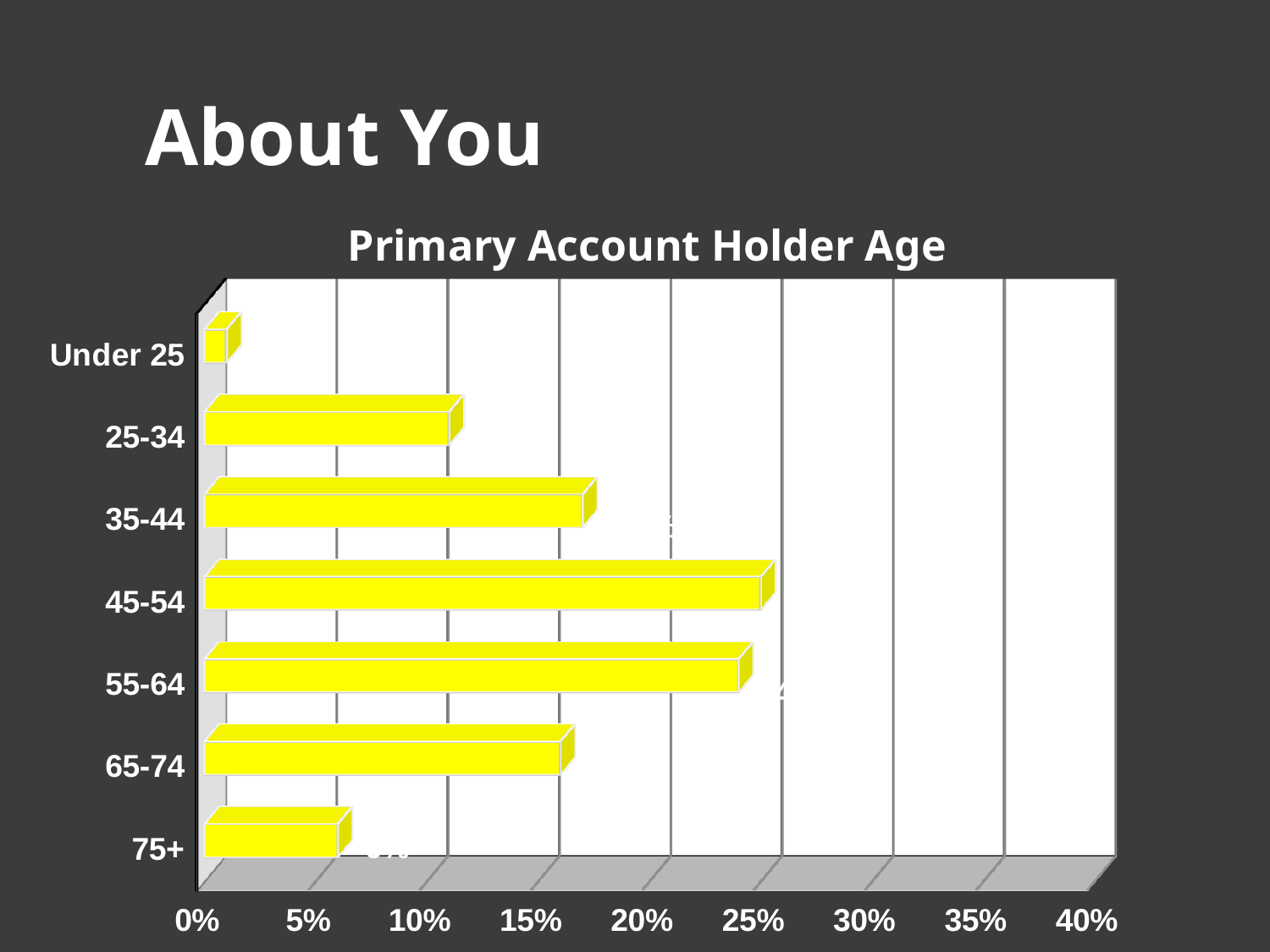
What kind of chart is shown on the slide? bar chart Which is larger, the value for 45-54 or the value for 25-34? 45-54 Is the value for 35-44 greater or less than 20%? less Is the value for 55-64 greater or less than 20%? greater Which age category has the lowest value? Under 25 Which is larger, the value for 65-74 or the value for 75+? 65-74 What is the title of the chart? Primary Account Holder Age Is the value for 65-74 greater or less than 10%? greater How many age categories are shown in the chart? 7